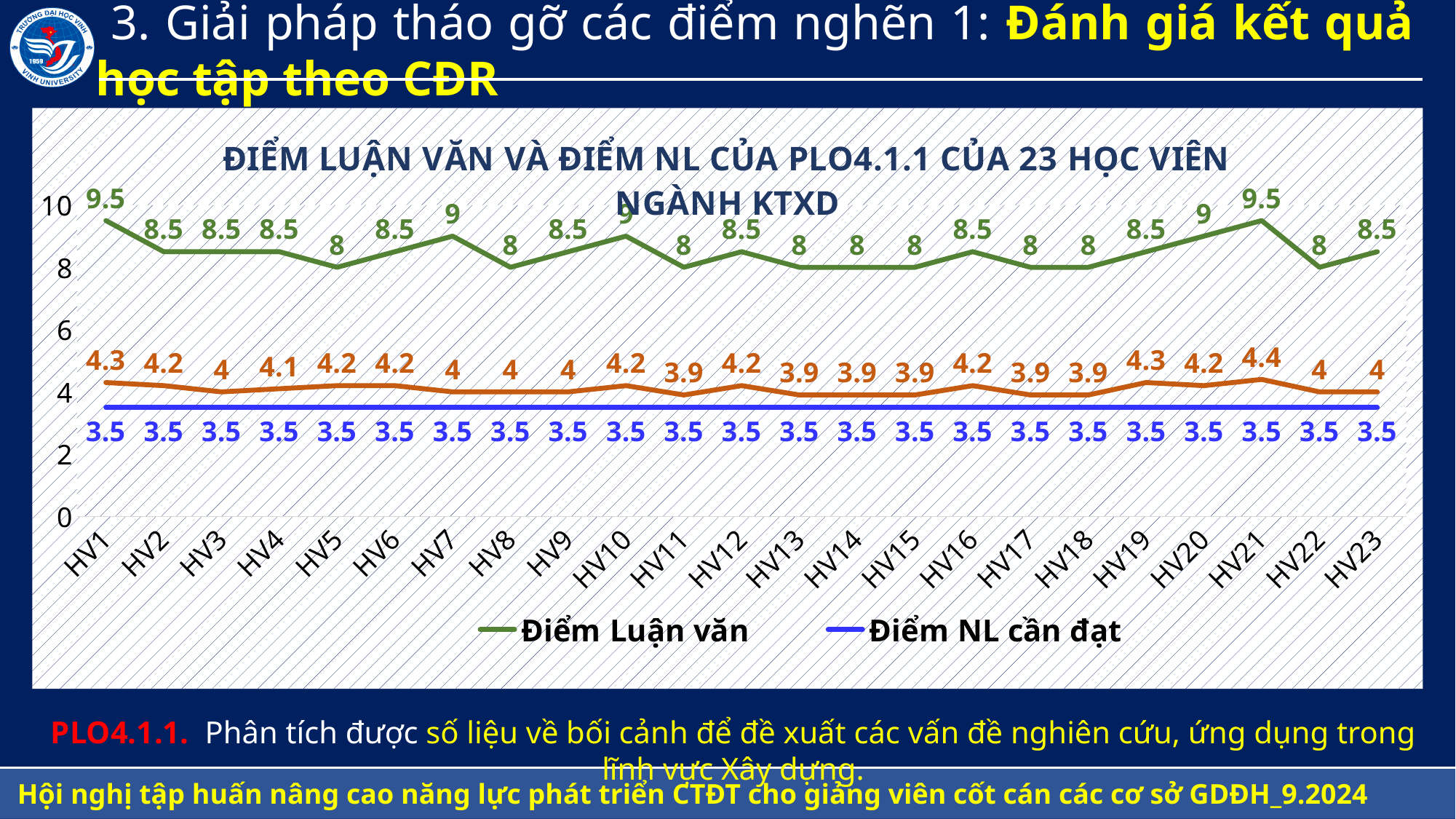
What is the lowest Điểm Luận văn value shown on the chart? 8 Which has a higher Điểm Luận văn value, HV1 or HV5? HV1 What is the Điểm Luận văn value for HV21? 9.5 How many series does the legend list? 2 What kind of chart is shown on the slide? Line chart How many học viên (HV categories) are shown on the x axis? 23 Does the Điểm NL cần đạt line rise, fall, or stay constant from HV1 to HV23? Stays constant What is the highest Điểm Luận văn value shown on the chart? 9.5 What is the Điểm NL cần đạt value for HV10? 3.5 What is the Điểm Luận văn value for HV7? 9 What is the difference between the Điểm Luận văn and Điểm NL cần đạt values for HV1? 6 What is the value of the orange line at HV21? 4.4